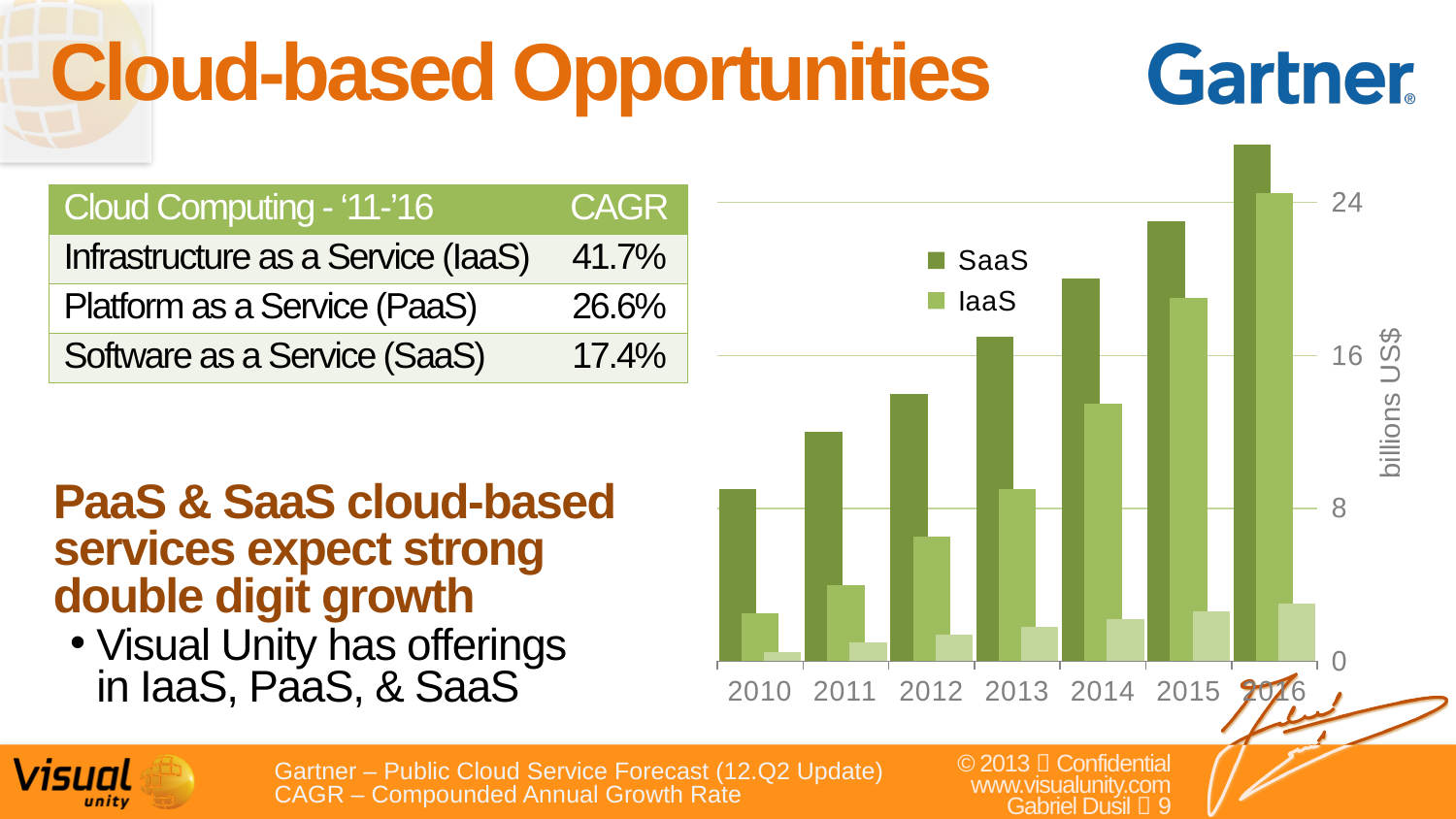
Which year has the highest SaaS value? 2016 Is the SaaS value for 2016 greater or less than 24? greater Which year has the lowest SaaS value? 2010 Do the SaaS values rise or fall from 2010 to 2016? rise Is the IaaS value for 2010 greater or less than 8? less How many series does the chart's legend list? 2 What unit is shown on the chart's vertical axis? billions US$ How many years are shown on the x axis of the chart? 7 In 2010, which is larger, the SaaS value or the IaaS value? SaaS What kind of chart is shown on the slide? bar chart Which series are listed in the chart's legend? SaaS and IaaS Do the IaaS values rise or fall from 2010 to 2016? rise